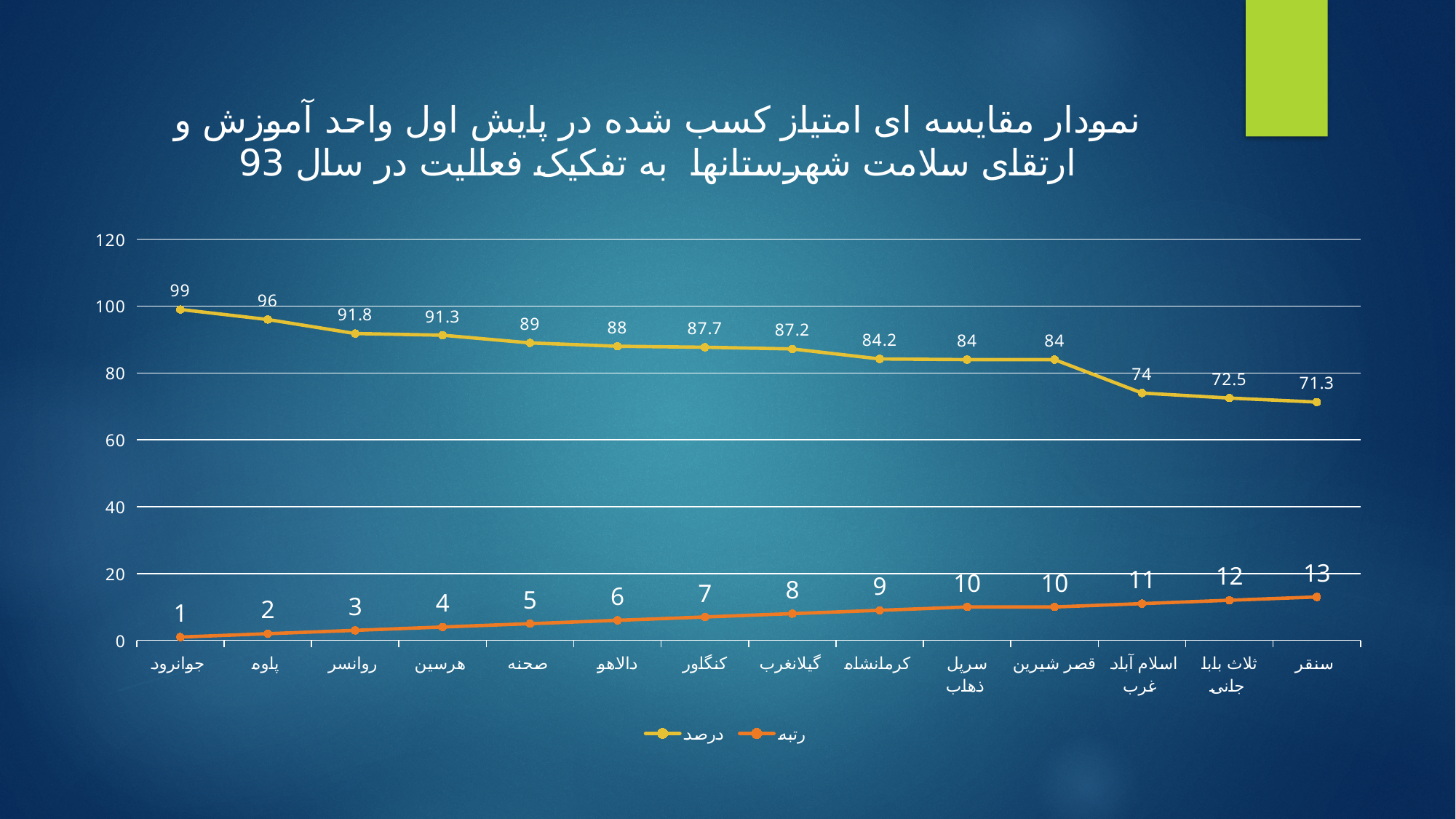
Which two categories share the رتبه value 10? سرپل ذهاب and قصر شیرین What is the difference between the درصد values for پاوه and سنقر? 24.7 How many series does the legend list? 2 Which has a higher درصد value, روانسر or هرسین? روانسر How many categories are shown on the x axis? 14 What is the درصد value for جوانرود? 99 What is the درصد value for کرمانشاه? 84.2 Which category has the lowest درصد value? سنقر What is the رتبه value for اسلام آباد غرب? 11 Do the درصد values rise or fall from left to right along the x axis? fall Which category has the highest درصد value? جوانرود What kind of chart is shown on the slide? line chart